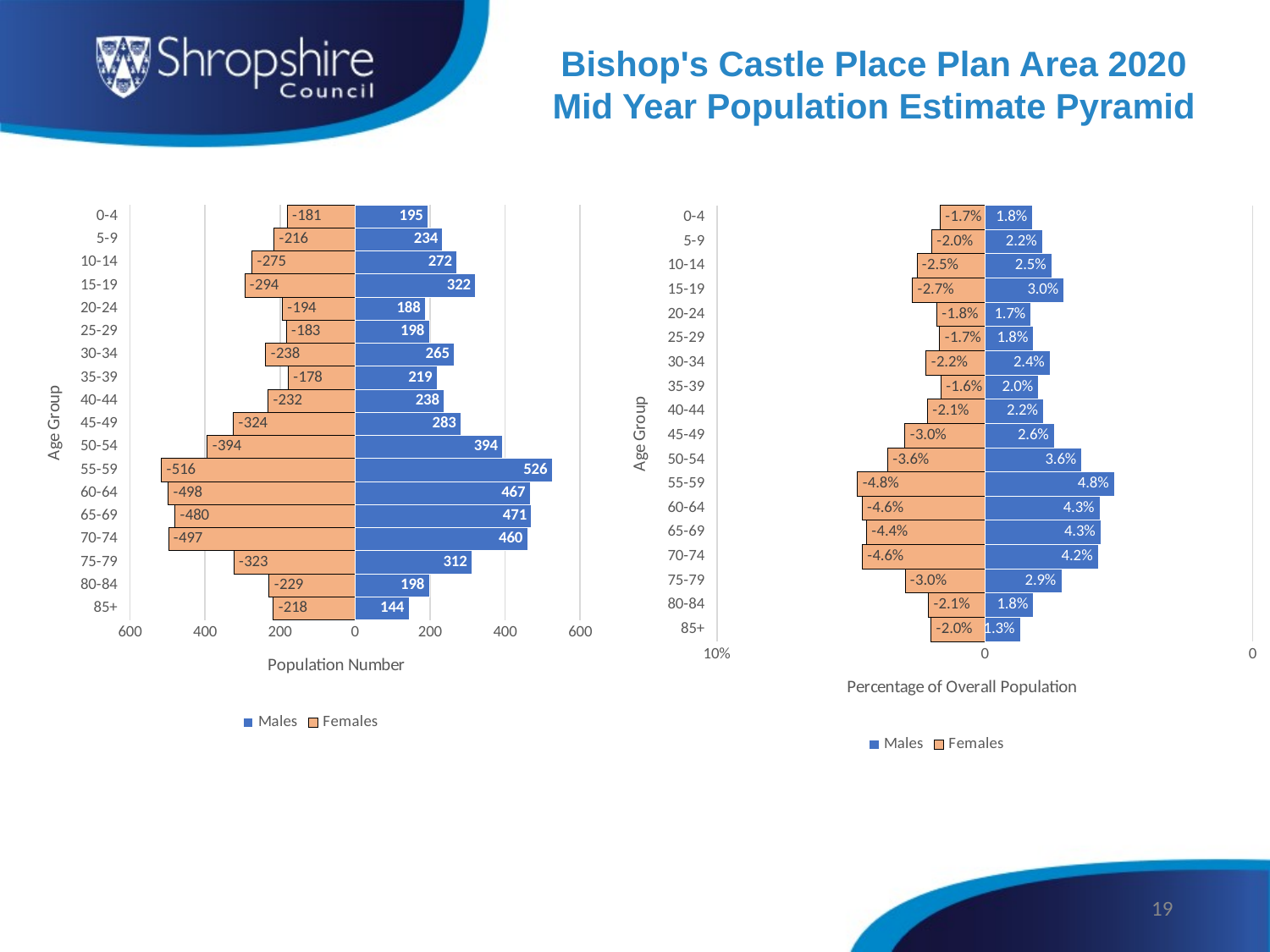
On the left chart (Population Number), which age group has the highest Males value? 55-59 On the left chart (Population Number), how many age groups are shown on the vertical axis? 18 On the right chart (Percentage of Overall Population), what is the Males value for the 55-59 age group? 4.8% On the left chart (Population Number), which age group has the lowest Males value? 85+ What kind of chart is the left chart (Population Number)? Bar chart On the left chart (Population Number), which is larger, the Males value for 15-19 or the Males value for 10-14? 15-19 On the left chart (Population Number), what is the difference between the Males values for 60-64 and 65-69? 4 On the right chart (Percentage of Overall Population), which age group has the lowest Males value? 85+ On the right chart (Percentage of Overall Population), what value is shown for Females in the 50-54 age group? -3.6% On the left chart (Population Number), what value is shown for Females in the 70-74 age group? -497 On the left chart (Population Number), how many series does the legend list? 2 On the left chart (Population Number), what is the value for Males in the 55-59 age group? 526